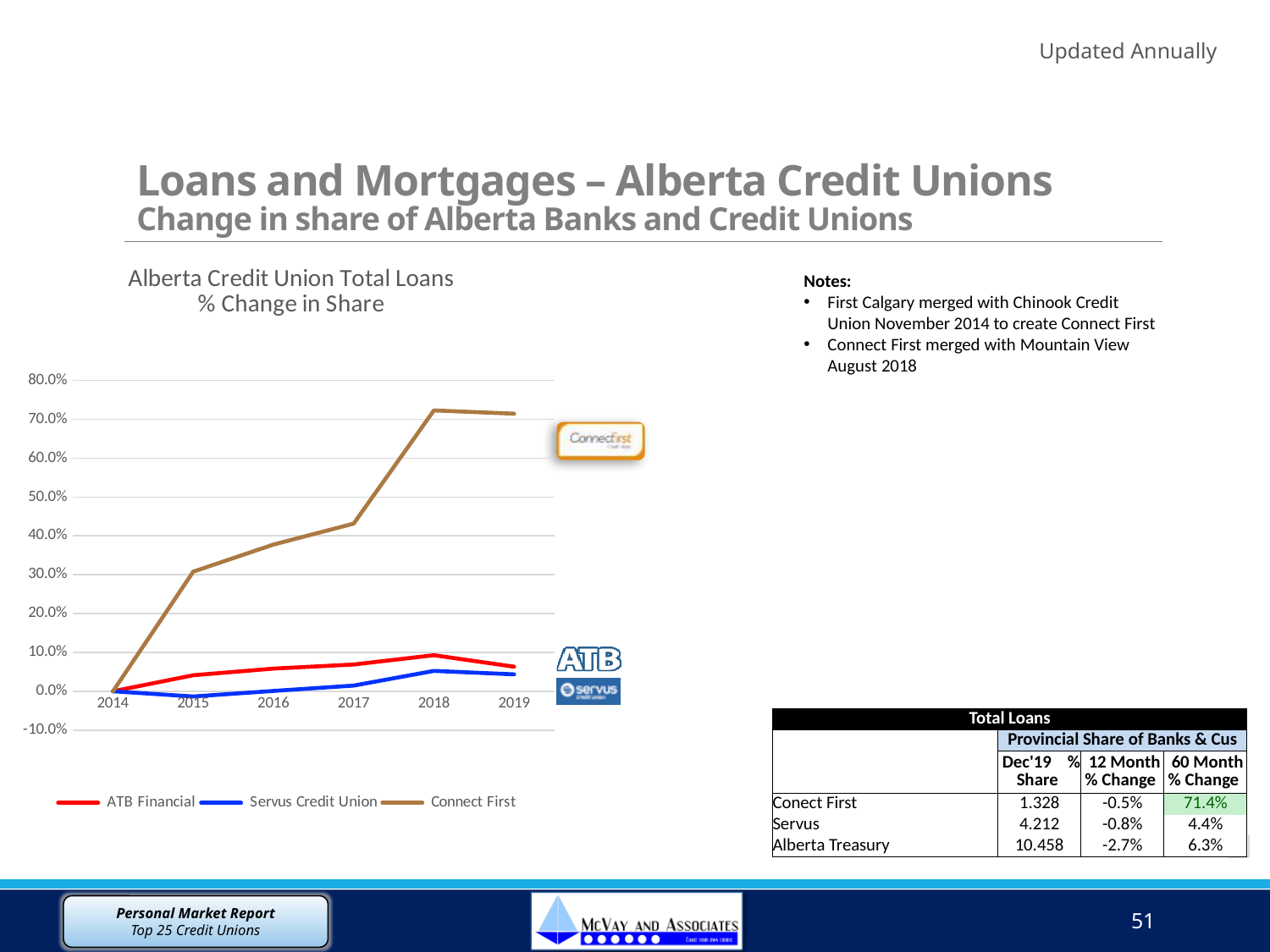
Which series has the highest value in 2019? Connect First What is the title of the chart? Alberta Credit Union Total Loans % Change in Share Is the value for Connect First in 2015 greater or less than 20.0%? greater What type of chart is shown on the slide? Line chart How many series does the chart legend list? 3 What value do all three series start at in 2014? 0.0% Is the value for ATB Financial in 2018 greater or less than 20.0%? less Is the value for Connect First in 2018 greater or less than 60.0%? greater Does the Connect First line rise or fall from 2014 to 2018? Rise Which series has the lowest value in 2018? Servus Credit Union In 2019, which is larger: the value for ATB Financial or the value for Servus Credit Union? ATB Financial How many years are plotted along the x axis of the chart? 6